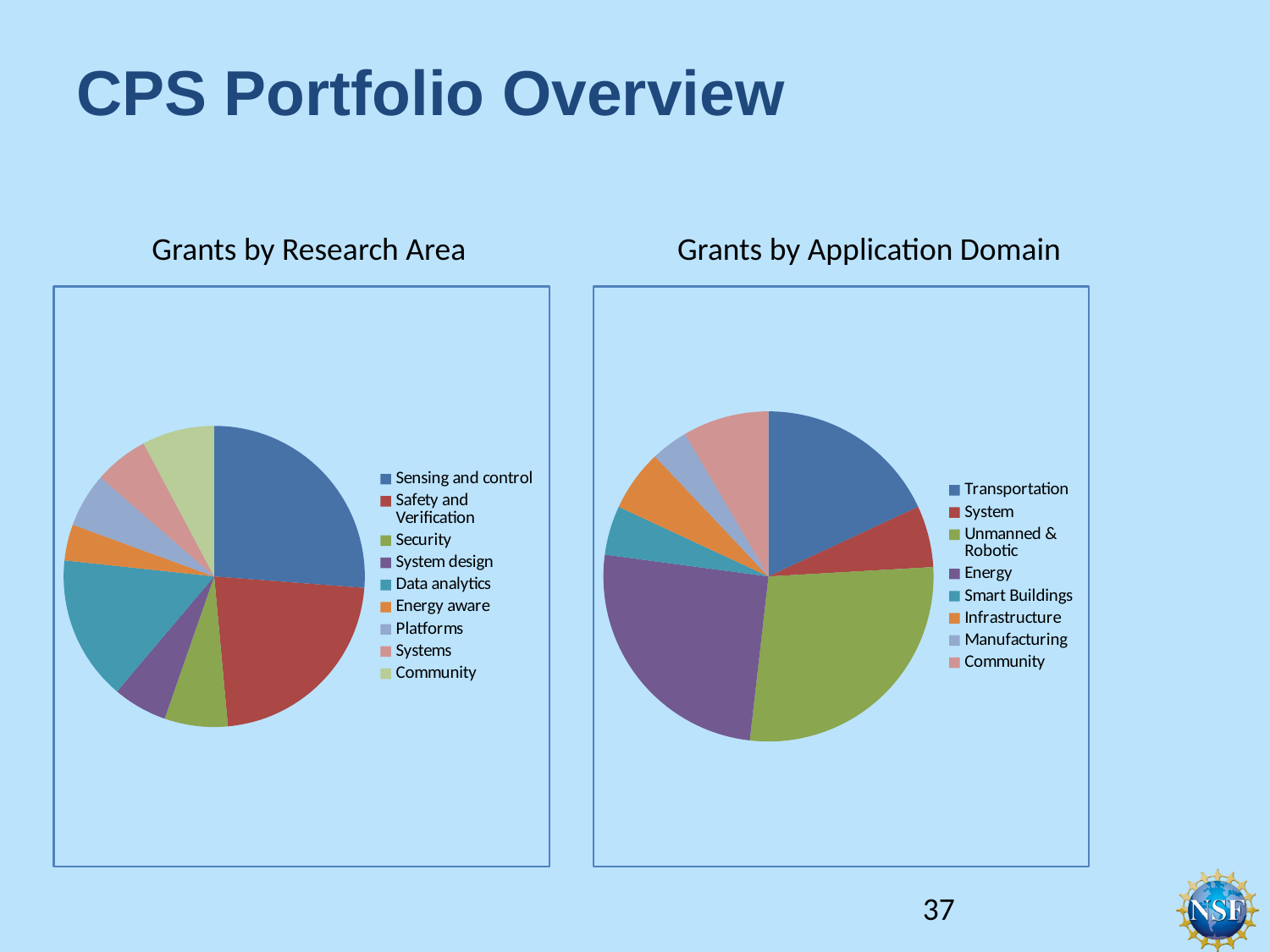
In the 'Grants by Application Domain' chart, which slice is larger: Transportation or System? Transportation In the 'Grants by Application Domain' chart, which category is shown in purple? Energy In the 'Grants by Research Area' chart, which research area has the largest slice? Sensing and control How many categories does the 'Grants by Application Domain' pie chart show? 8 What type of chart is the 'Grants by Application Domain' chart? pie chart In the 'Grants by Application Domain' chart, which application domain has the largest slice? Unmanned & Robotic What is the title of the pie chart on the left side of the slide? Grants by Research Area In the 'Grants by Research Area' chart, which slice is larger: Safety and Verification or Data analytics? Safety and Verification How many categories does the 'Grants by Research Area' pie chart show? 9 In the 'Grants by Research Area' chart, which slice is larger: Sensing and control or Security? Sensing and control What type of chart is the 'Grants by Research Area' chart? pie chart